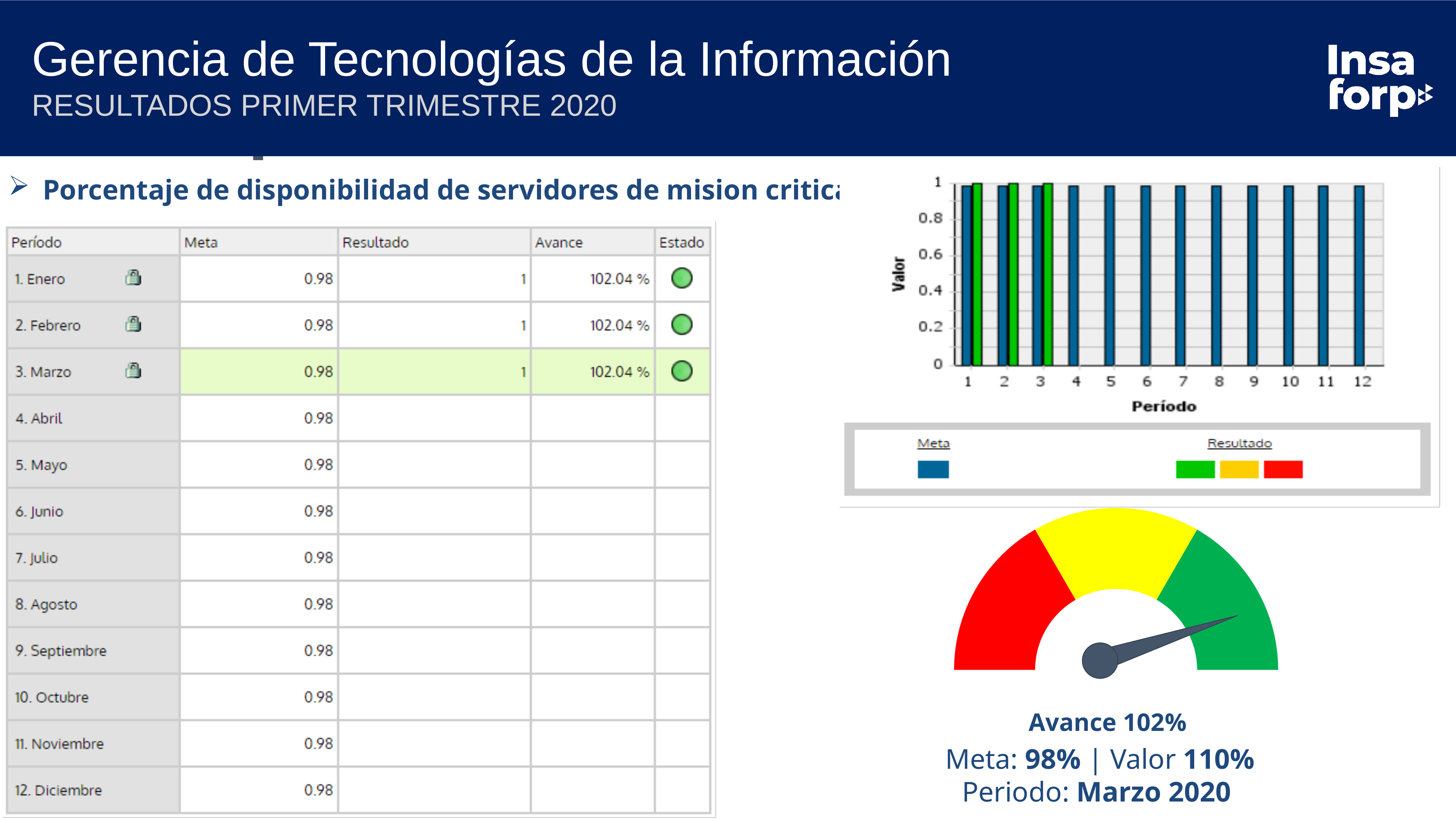
In the bar chart, what is the label of the y axis? Valor What kind of chart is the chart at the top right of the slide? bar chart In the bar chart, how many series does the legend list? 2 In the bar chart, for how many periods is a Resultado (green) bar plotted? 3 On the gauge chart, which is larger, the Meta or the Valor? Valor On the gauge chart, what Avance percentage is shown? 102% In the bar chart, do the Meta values rise, fall or stay flat across periods 1 to 12? stay flat In the bar chart, what are the two series named in the legend? Meta and Resultado In the bar chart, what is the Resultado value for period 1? 1 On the gauge chart, what is the Valor shown? 110% In the bar chart, is the Meta value for period 6 greater or less than 0.8? greater In the bar chart, how many periods are shown on the x axis? 12